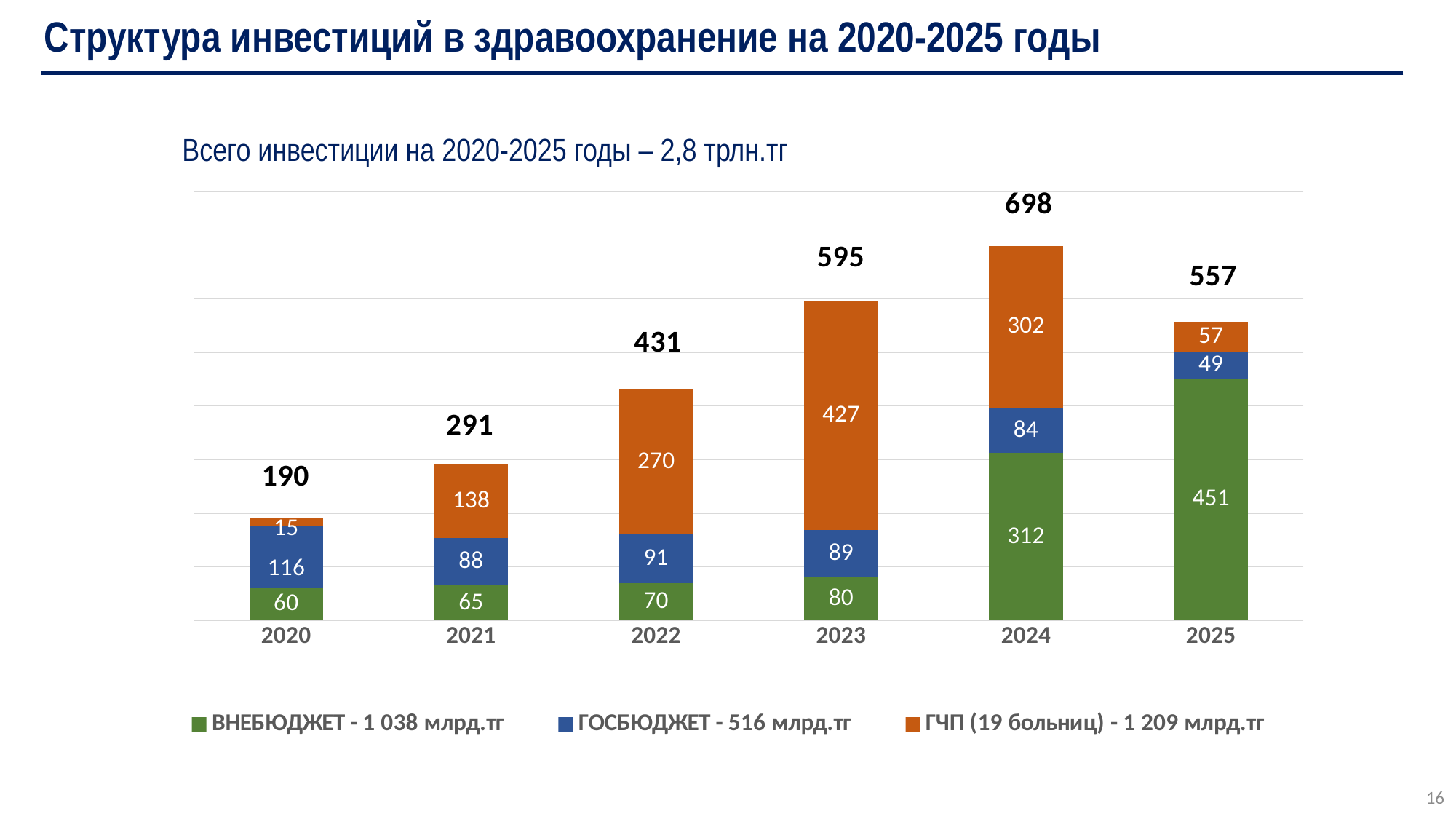
What type of chart is shown on the slide? Stacked bar chart Does the ВНЕБЮДЖЕТ value rise or fall from 2020 to 2025? Rise Which is larger, the ВНЕБЮДЖЕТ value for 2025 or the ГЧП value for 2023? ВНЕБЮДЖЕТ value for 2025 What is the ГОСБЮДЖЕТ value for 2020? 116 How many series does the legend list? 3 What is the ВНЕБЮДЖЕТ value for 2024? 312 Which year has the lowest total investment? 2020 How many years are shown on the x axis? 6 Which year has the highest total investment? 2024 What is the difference between the ГЧП values for 2024 and 2025? 245 What is the total of the stacked bar for 2025? 557 What is the ГЧП value for 2023? 427